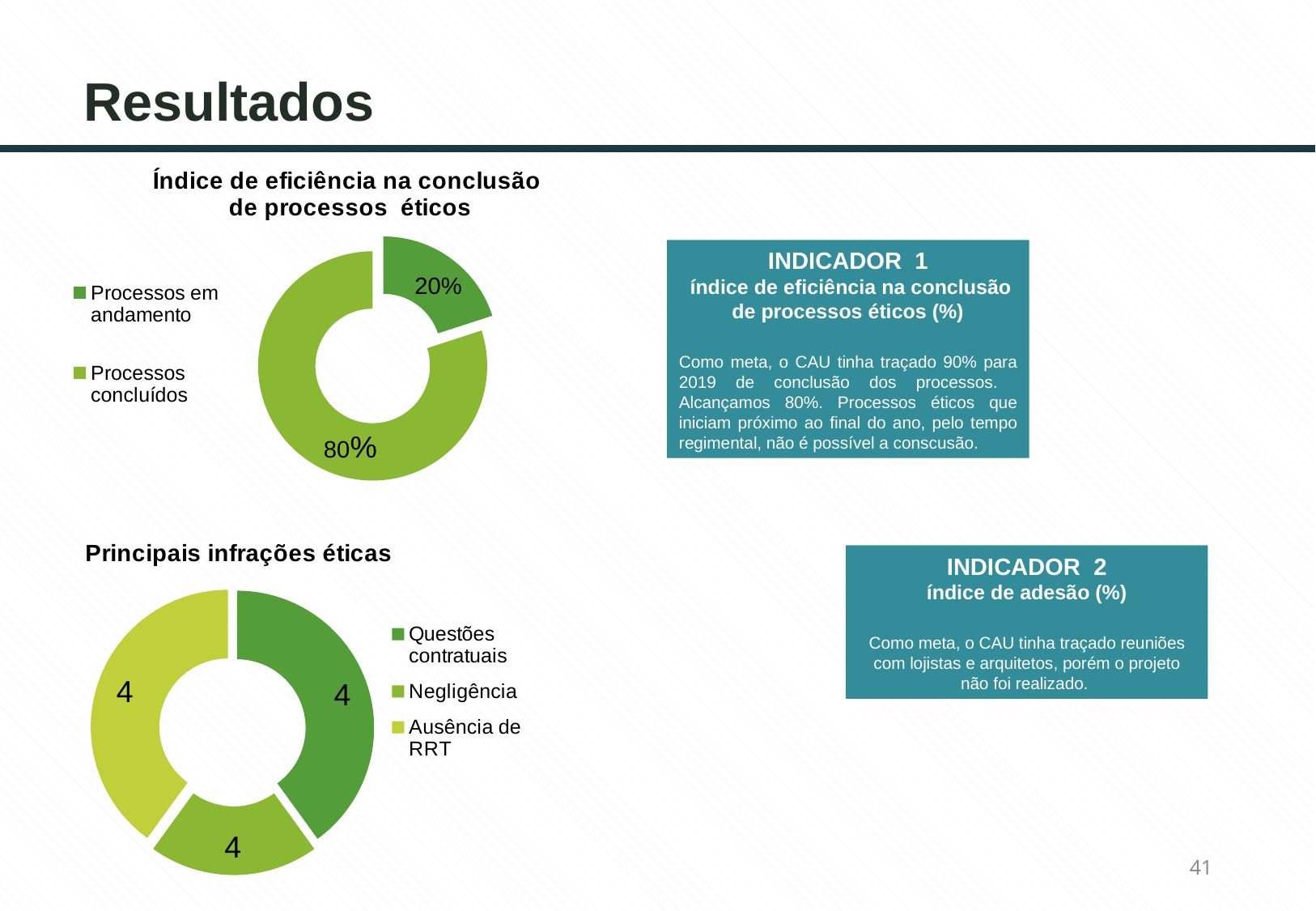
In the chart titled "Índice de eficiência na conclusão de processos éticos", what percentage is shown for "Processos concluídos"? 80% In the chart titled "Índice de eficiência na conclusão de processos éticos", what percentage is shown for "Processos em andamento"? 20% In the chart titled "Índice de eficiência na conclusão de processos éticos", what is the difference in percentage points between "Processos concluídos" and "Processos em andamento"? 60 In the chart titled "Principais infrações éticas", which legend entry is shown in the darkest green? Questões contratuais In the chart titled "Principais infrações éticas", what is the total of all three values? 12 In the chart titled "Índice de eficiência na conclusão de processos éticos", which category has the largest share? Processos concluídos What kind of chart is the one titled "Índice de eficiência na conclusão de processos éticos"? Doughnut chart In the chart titled "Índice de eficiência na conclusão de processos éticos", how many categories does the legend list? 2 In the chart titled "Índice de eficiência na conclusão de processos éticos", which category has the smallest share? Processos em andamento In the chart titled "Principais infrações éticas", how many categories does the legend list? 3 In the chart titled "Principais infrações éticas", what value is shown for "Ausência de RRT"? 4 In the chart titled "Principais infrações éticas", what value is shown for "Negligência"? 4